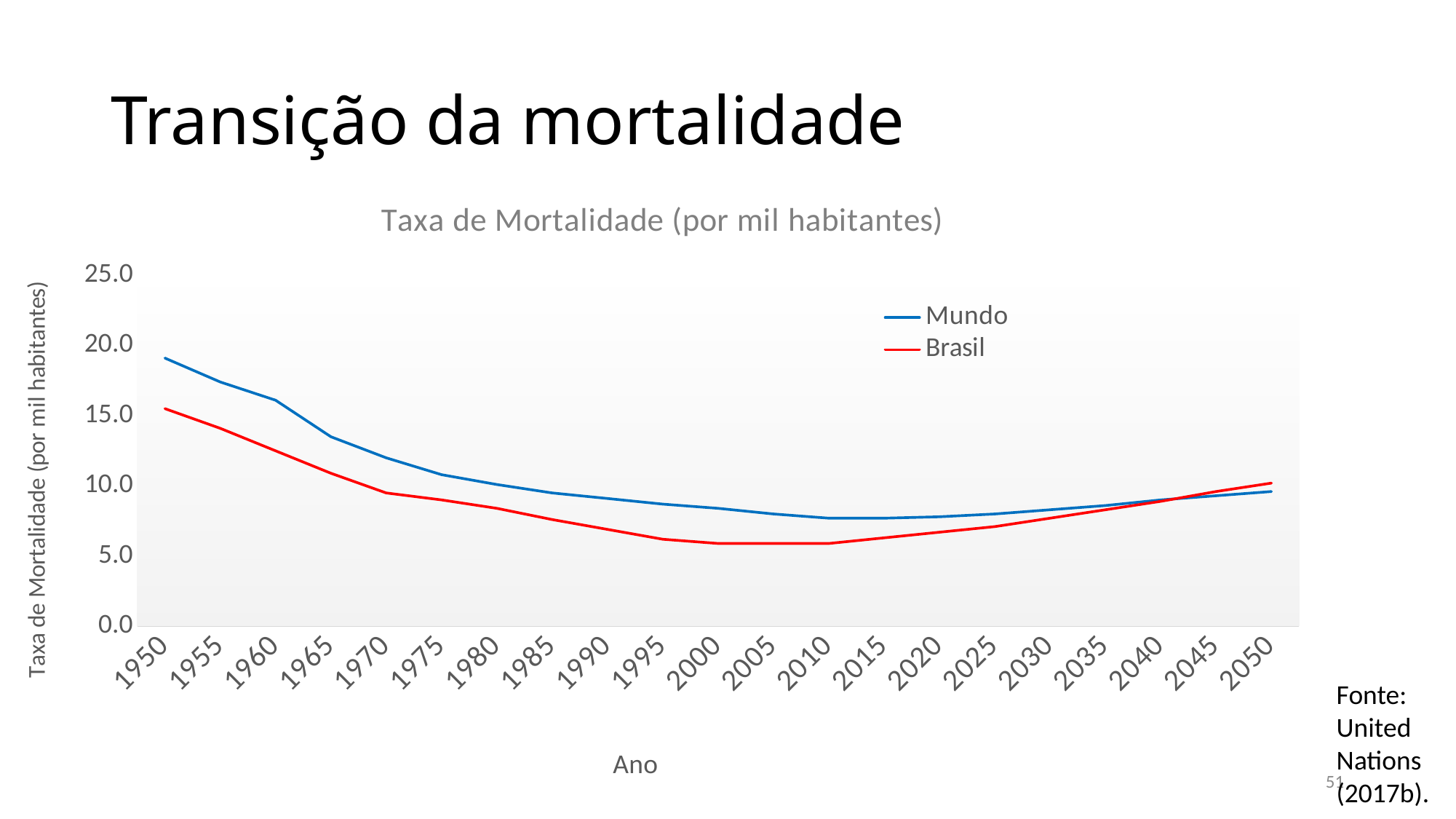
Is the value for Mundo in 2010 greater or less than 10.0? less How many series does the legend list? 2 In which year is the Mundo series at its highest? 1950 How many years are marked along the x axis? 21 What is the title of the chart? Taxa de Mortalidade (por mil habitantes) What kind of chart is shown on the slide? line chart Is the value for Brasil in 1950 greater or less than 20.0? less Is the value for Brasil in 2005 greater or less than 10.0? less Does the Brasil series rise or fall between 1950 and 2005? fall In 2050, which series has the higher mortality rate, Mundo or Brasil? Brasil In 1950, which series has the higher mortality rate, Mundo or Brasil? Mundo